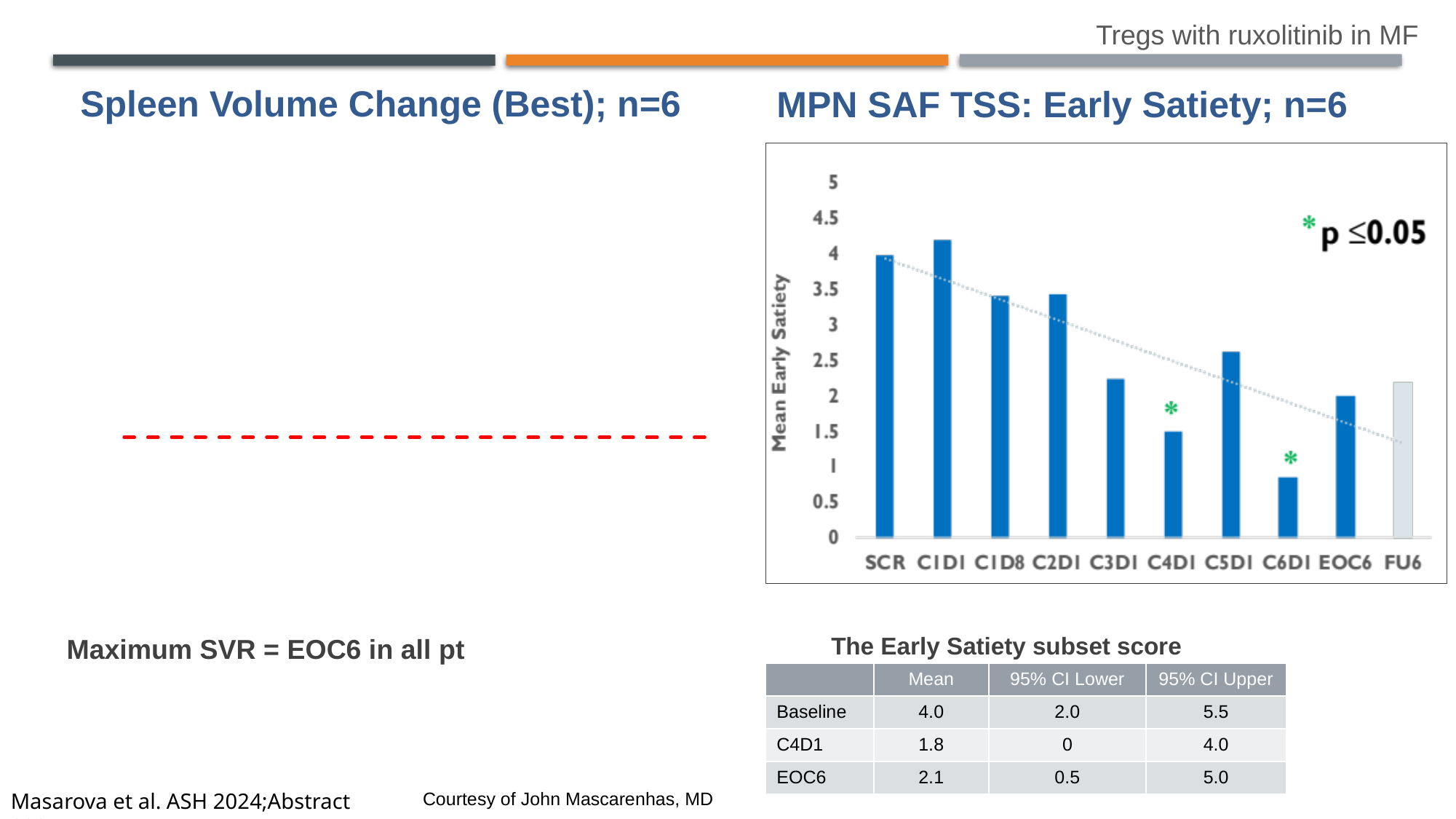
In the MPN SAF TSS: Early Satiety chart, is the value for C6D1 greater or less than 1? less In the MPN SAF TSS: Early Satiety chart, how many time points are shown on the x axis? 10 In the MPN SAF TSS: Early Satiety chart, which time point has the highest mean early satiety? C1D1 In the MPN SAF TSS: Early Satiety chart, is the value for C1D1 greater or less than 4? greater In the MPN SAF TSS: Early Satiety chart, which is larger, the value for C3D1 or the value for C5D1? C5D1 In the MPN SAF TSS: Early Satiety chart, is the value for C3D1 greater or less than 2? greater In the MPN SAF TSS: Early Satiety chart, which time point has the lowest mean early satiety? C6D1 What is the y-axis label of the MPN SAF TSS: Early Satiety chart? Mean Early Satiety In the MPN SAF TSS: Early Satiety chart, which time points are marked with a green asterisk? C4D1 and C6D1 In the MPN SAF TSS: Early Satiety chart, do the values generally rise or fall from SCR to FU6? fall What kind of chart is shown under the title 'MPN SAF TSS: Early Satiety; n=6'? bar chart